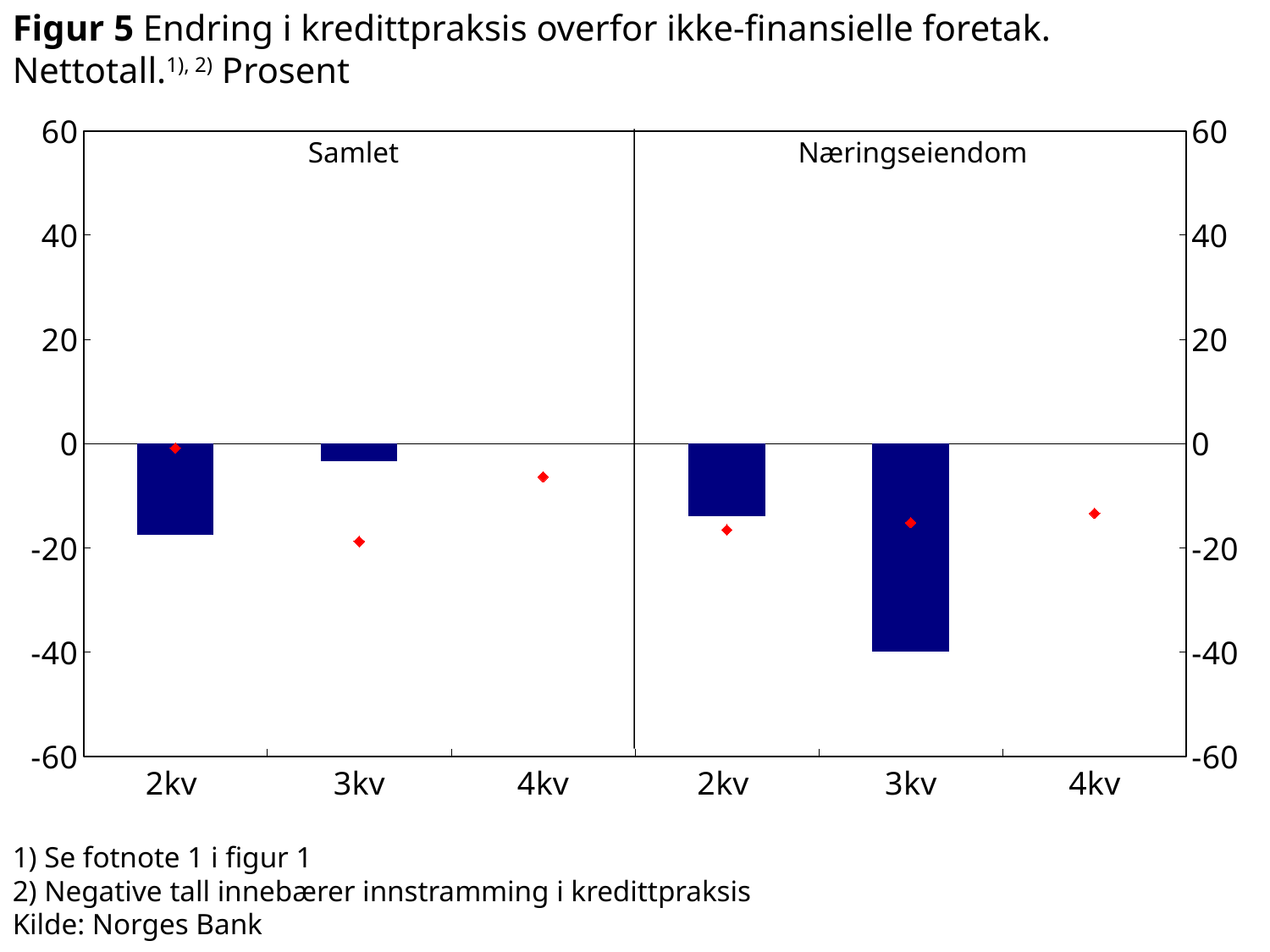
How many quarters are shown on the x axis of each panel? 3 What are the titles of the two panels in the chart? Samlet and Næringseiendom In the Samlet panel, which bar is lower, 2kv or 3kv? 2kv Which quarter has no bar in either panel, only a red marker? 4kv In the Samlet panel, is the bar for 2kv greater or less than -20? greater In the Næringseiendom panel, do the bars rise or fall from 2kv to 3kv? fall What kind of chart is shown in Figur 5? bar chart In the Næringseiendom panel, which bar is lower, 2kv or 3kv? 3kv In the Næringseiendom panel, is the bar for 3kv greater or less than -20? less In the Samlet panel, is the bar for 3kv greater or less than -20? greater In which panel and quarter is the lowest bar found? Næringseiendom, 3kv How many bars are plotted in the Samlet panel? 2